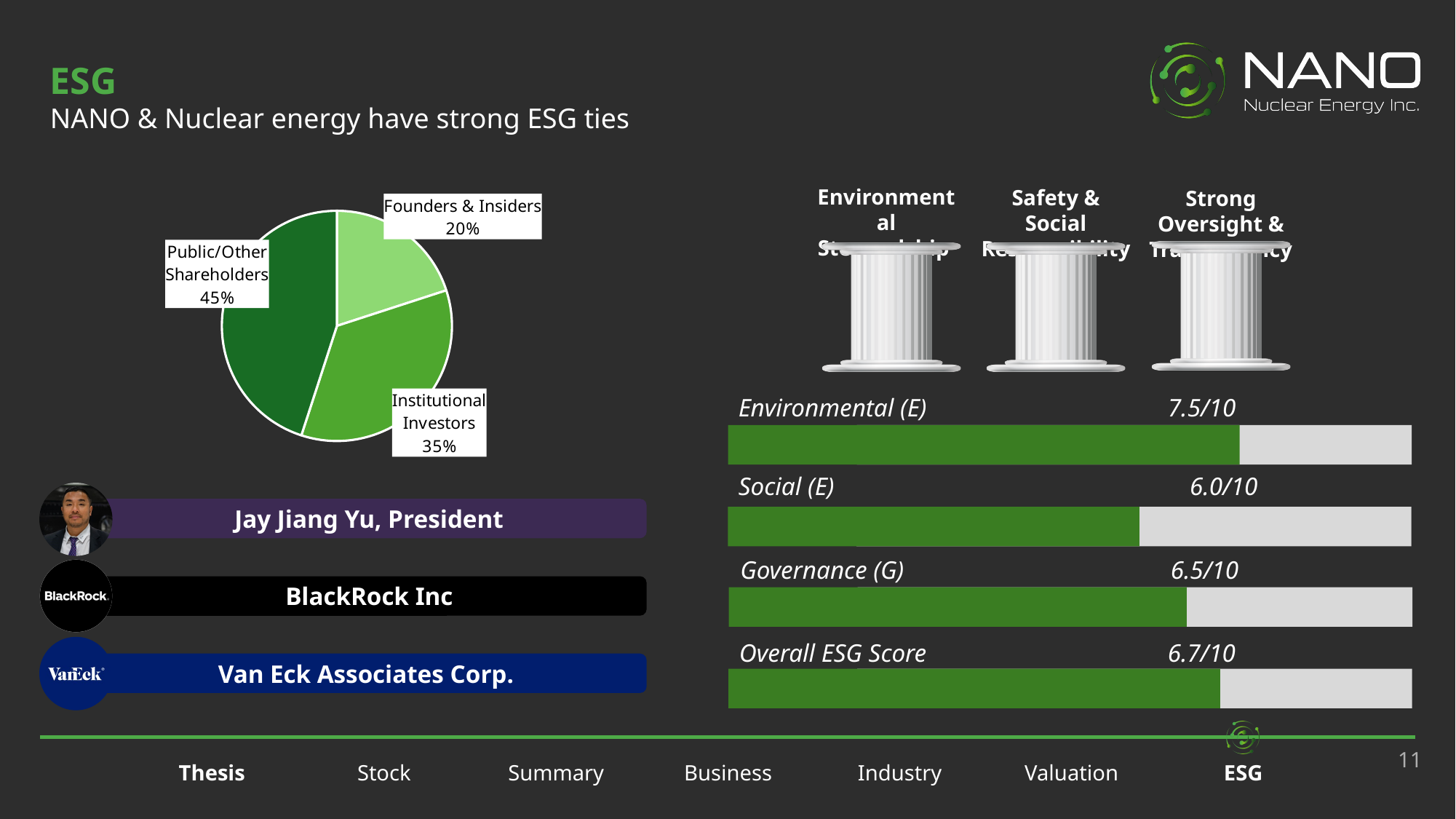
In the pie chart on the left, which category has the smallest share? Founders & Insiders In the pie chart on the left, what share of shareholders is Institutional Investors? 35% In the ESG score bars on the right, what is the Overall ESG Score? 6.7/10 In the pie chart on the left, what share is Public/Other Shareholders? 45% In the pie chart on the left, what share is Founders & Insiders? 20% In the pie chart on the left, which category has the largest share? Public/Other Shareholders In the ESG score bars on the right, which category has the lowest score? Social (E) What type of chart is shown on the left of the slide? Pie chart In the ESG score bars on the right, which is higher, Governance (G) or Social (E)? Governance (G) In the ESG score bars on the right, what is the Environmental (E) score? 7.5/10 In the pie chart on the left, how many slices are there? 3 In the pie chart on the left, what is the difference in percentage points between Public/Other Shareholders and Institutional Investors? 10